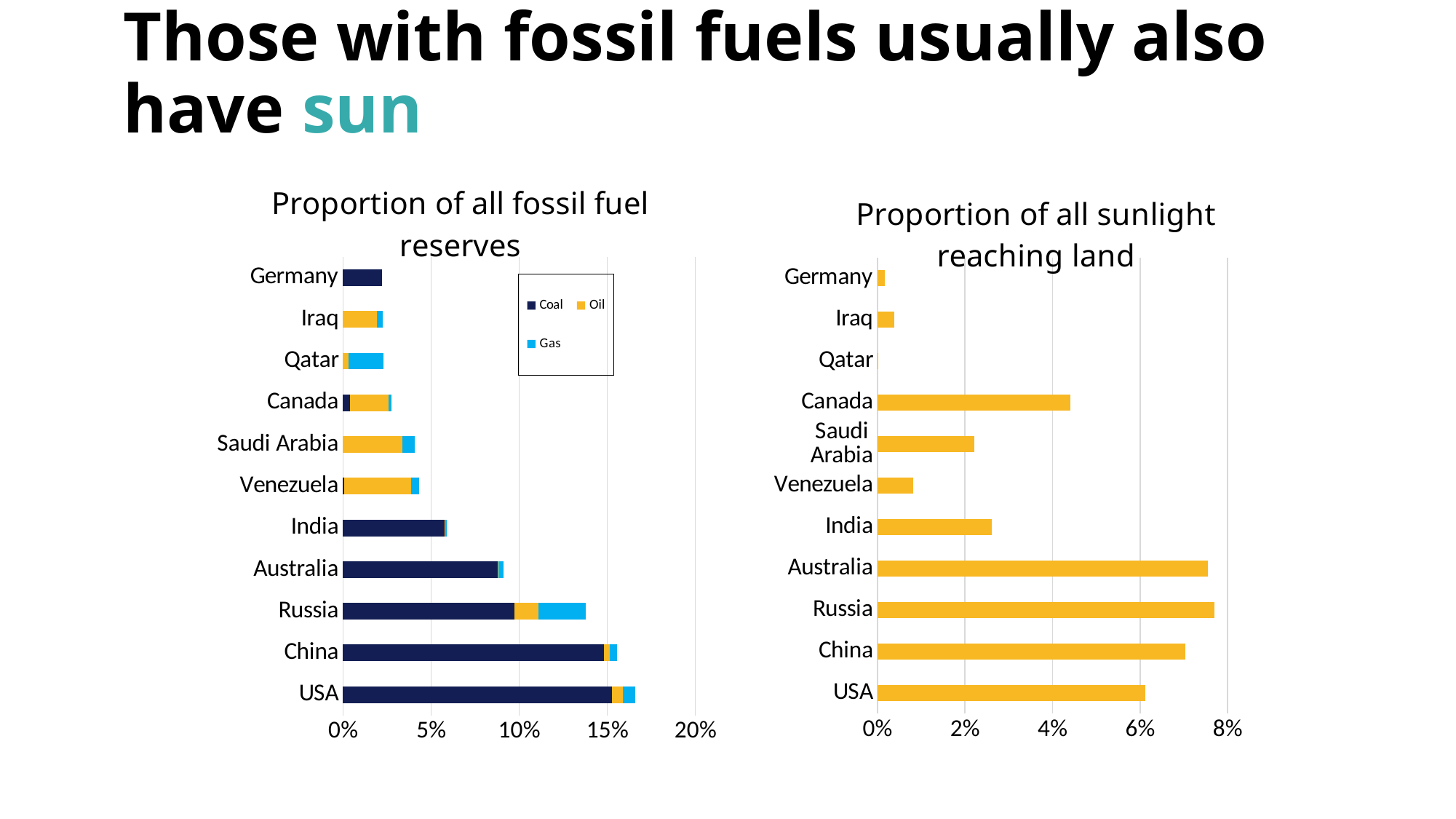
In the 'Proportion of all fossil fuel reserves' chart, which series is shown in light blue? Gas In the 'Proportion of all fossil fuel reserves' chart, is the total value for Russia greater or less than 10%? greater In the 'Proportion of all sunlight reaching land' chart, which country has the lowest value? Qatar What type of chart is the 'Proportion of all fossil fuel reserves' chart? Stacked bar chart In the 'Proportion of all fossil fuel reserves' chart, which country has the largest total bar? USA In the 'Proportion of all sunlight reaching land' chart, is the value for Venezuela greater or less than 2%? less How many series does the legend list in the 'Proportion of all fossil fuel reserves' chart? 3 How many countries are shown in the 'Proportion of all sunlight reaching land' chart? 11 In the 'Proportion of all sunlight reaching land' chart, is the value for Canada greater or less than 4%? greater In the 'Proportion of all sunlight reaching land' chart, which is larger, the value for Canada or the value for India? Canada